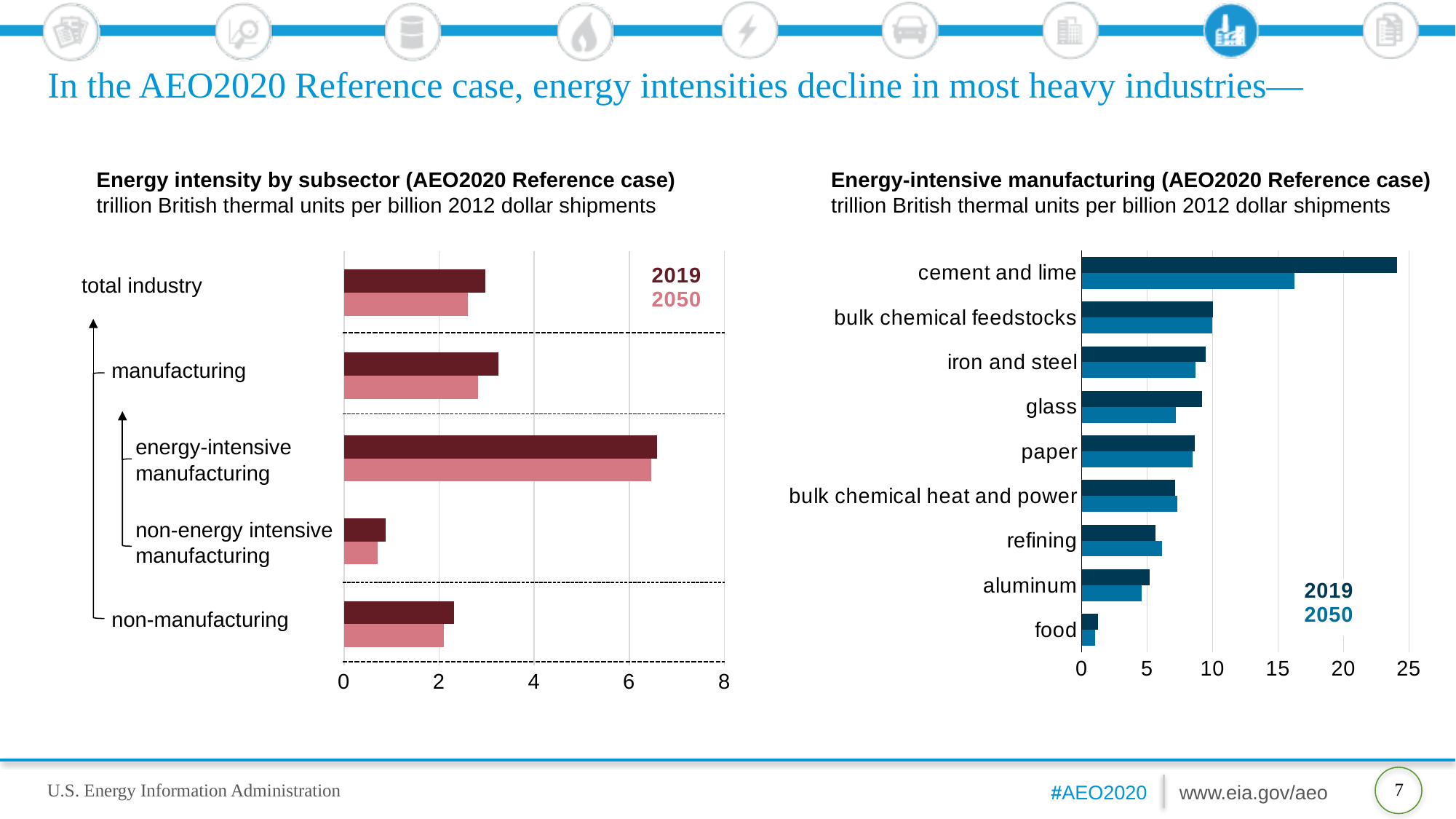
In the 'Energy-intensive manufacturing' chart on the right, which is larger for aluminum: the 2019 value or the 2050 value? 2019 In the 'Energy intensity by subsector' chart on the left, which category has the lowest 2019 value? non-energy intensive manufacturing In the 'Energy intensity by subsector' chart on the left, how many subsector categories are shown? 5 In the 'Energy-intensive manufacturing' chart on the right, which industry has the highest 2019 value? cement and lime What kind of chart is the 'Energy intensity by subsector (AEO2020 Reference case)' chart on the left? bar chart In the 'Energy intensity by subsector' chart on the left, how many series does the legend list? 2 In the 'Energy-intensive manufacturing' chart on the right, is the 2019 value for cement and lime greater or less than 20? greater In the 'Energy intensity by subsector' chart on the left, which is larger for total industry: the 2019 value or the 2050 value? 2019 In the 'Energy-intensive manufacturing (AEO2020 Reference case)' chart on the right, how many industry categories are shown? 9 In the 'Energy-intensive manufacturing' chart on the right, which industry has the lowest 2050 value? food In the 'Energy intensity by subsector' chart on the left, is the 2019 value for energy-intensive manufacturing greater or less than 6? greater In the 'Energy intensity by subsector' chart on the left, which category has the highest 2019 value? energy-intensive manufacturing